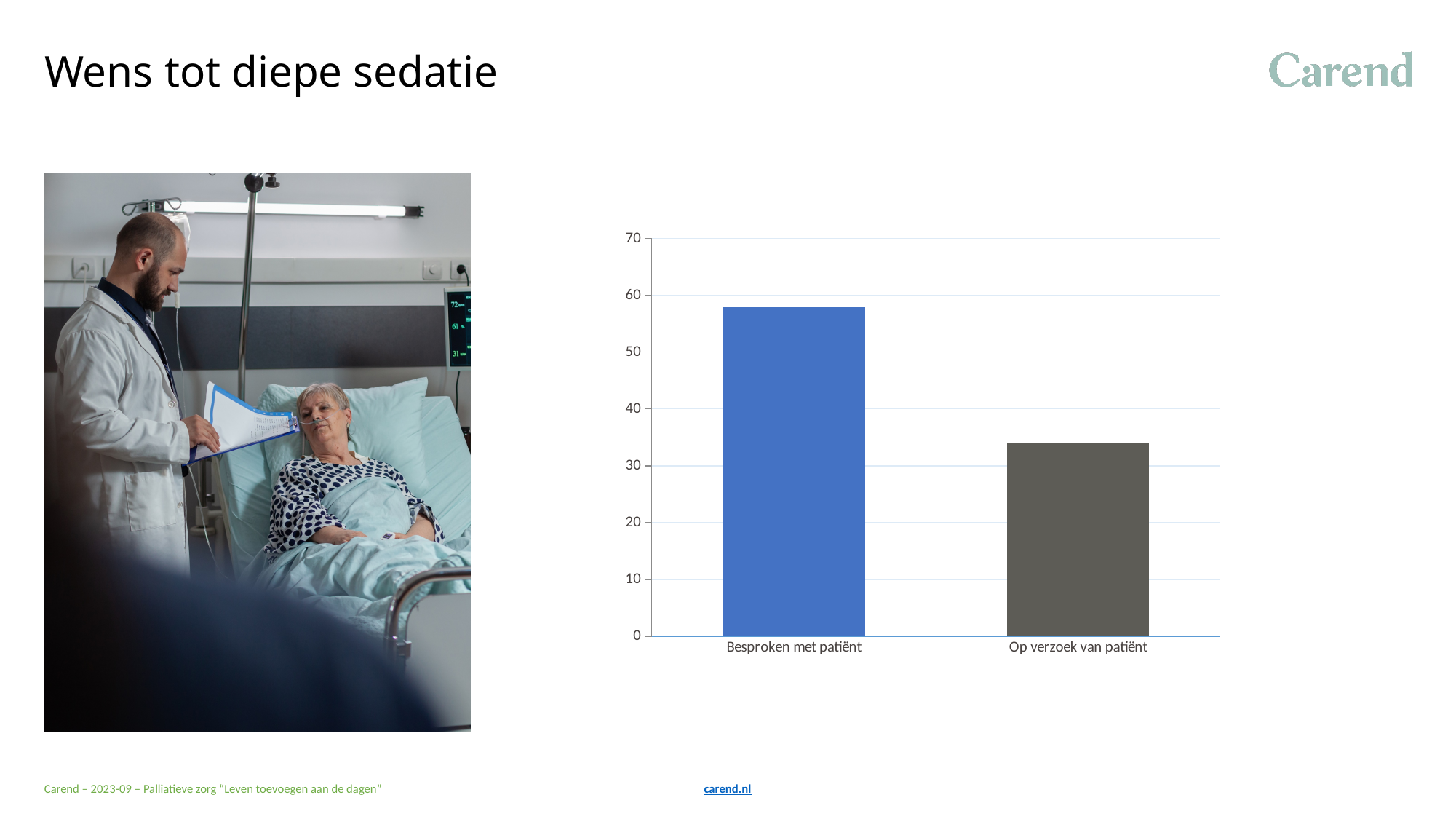
Is the value for Op verzoek van patiënt greater or less than 40? less What kind of chart is shown on the slide? bar chart How many categories are shown on the x axis of the chart? 2 Which category has the lowest bar? Op verzoek van patiënt Do the values fall or rise from the left bar to the right bar? fall What colour is the bar for Besproken met patiënt? blue Which is larger, the value for Besproken met patiënt or the value for Op verzoek van patiënt? Besproken met patiënt Is the value for Op verzoek van patiënt greater or less than 30? greater Is the value for Besproken met patiënt greater or less than 50? greater What is the highest value shown on the y axis of the chart? 70 Which category has the highest bar? Besproken met patiënt